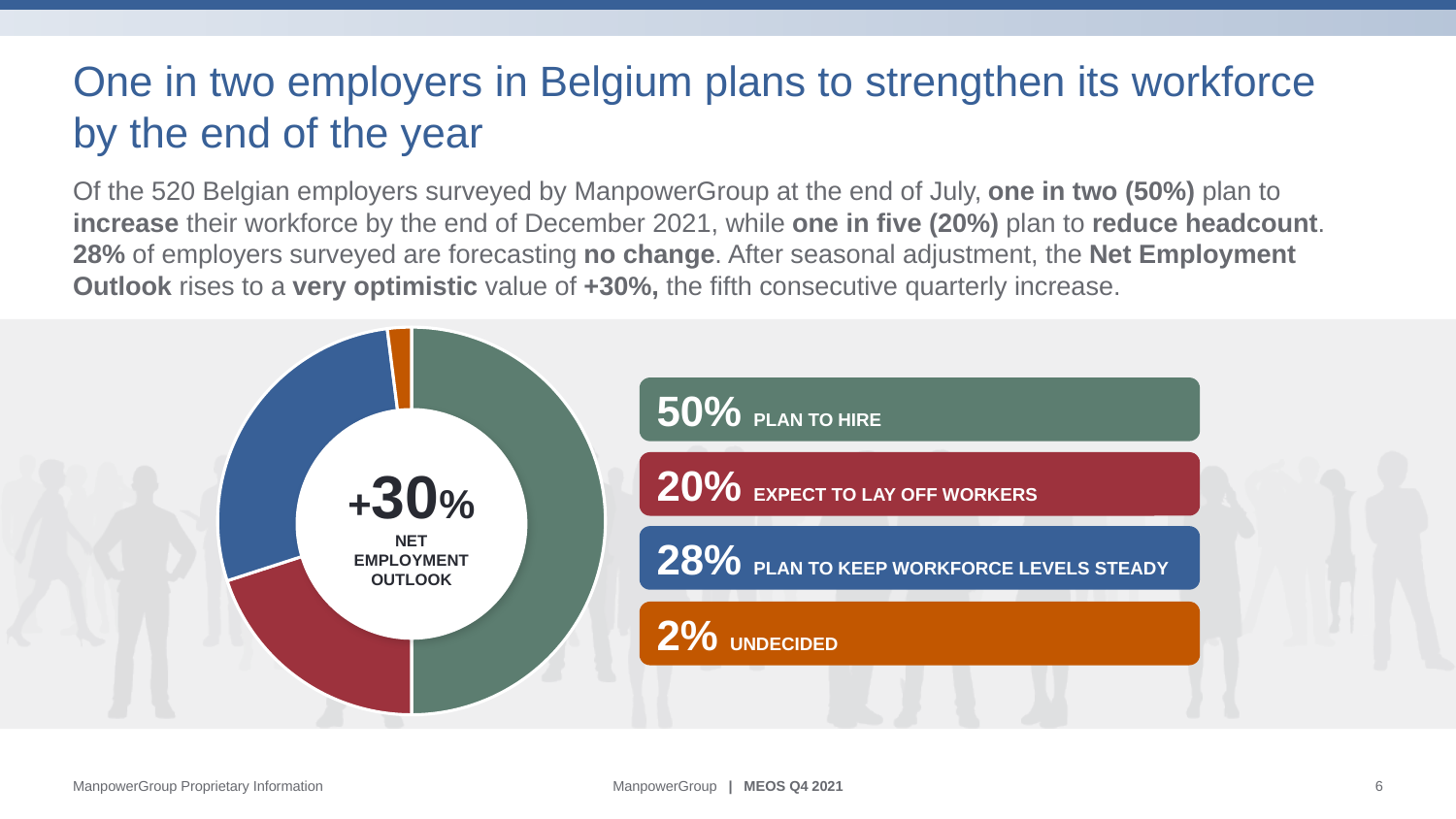
What share of employers plan to keep workforce levels steady? 28% Which is larger: the share that plan to keep workforce levels steady or the share that expect to lay off workers? Plan to keep workforce levels steady How many segments does the donut chart have? 4 What type of chart is shown on the slide? Donut (pie) chart What share of employers plan to hire? 50% What is the Net Employment Outlook value shown in the centre of the donut chart? +30% What colour is the segment representing employers who plan to hire? Green Which category has the largest share of the donut chart? Plan to hire What share of employers expect to lay off workers? 20% What share of employers are undecided? 2% Which category has the smallest share of the donut chart? Undecided What is the difference between the share that plan to hire and the share that expect to lay off workers? 30 percentage points